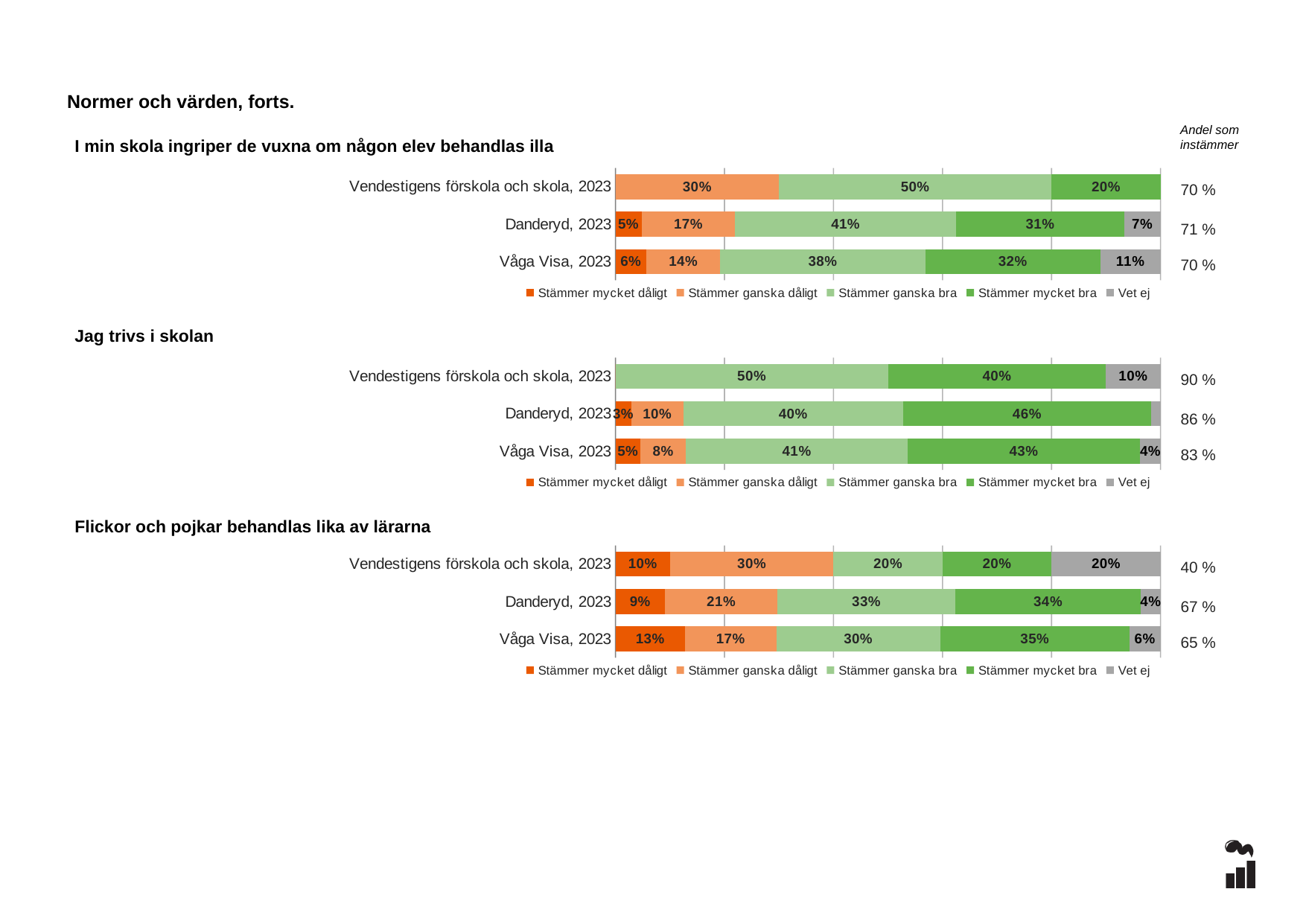
In the chart 'I min skola ingriper de vuxna om någon elev behandlas illa', which category has the highest 'Stämmer ganska bra' value? Vendestigens förskola och skola, 2023 In the chart 'I min skola ingriper de vuxna om någon elev behandlas illa', what is the 'Vet ej' value for Våga Visa, 2023? 11% In the chart 'Flickor och pojkar behandlas lika av lärarna', what is the 'Stämmer mycket dåligt' value for Våga Visa, 2023? 13% How many categories are shown in the chart 'Flickor och pojkar behandlas lika av lärarna'? 3 In the chart 'Flickor och pojkar behandlas lika av lärarna', what is the difference between the 'Stämmer ganska dåligt' values for Vendestigens förskola och skola, 2023 and Danderyd, 2023? 9% How many series does the legend of the chart 'Jag trivs i skolan' list? 5 In the chart 'I min skola ingriper de vuxna om någon elev behandlas illa', what is the 'Stämmer ganska bra' value for Vendestigens förskola och skola, 2023? 50% In the chart 'Flickor och pojkar behandlas lika av lärarna', which category has the lowest 'Stämmer mycket bra' value? Vendestigens förskola och skola, 2023 In the chart 'Jag trivs i skolan', what is the difference between the 'Stämmer mycket bra' values for Danderyd, 2023 and Vendestigens förskola och skola, 2023? 6% In the chart 'Jag trivs i skolan', what is the 'Stämmer mycket bra' value for Danderyd, 2023? 46% What kind of chart is 'I min skola ingriper de vuxna om någon elev behandlas illa'? Stacked bar chart In the chart 'Jag trivs i skolan', which is larger: the 'Stämmer ganska bra' value for Våga Visa, 2023 or for Danderyd, 2023? Våga Visa, 2023